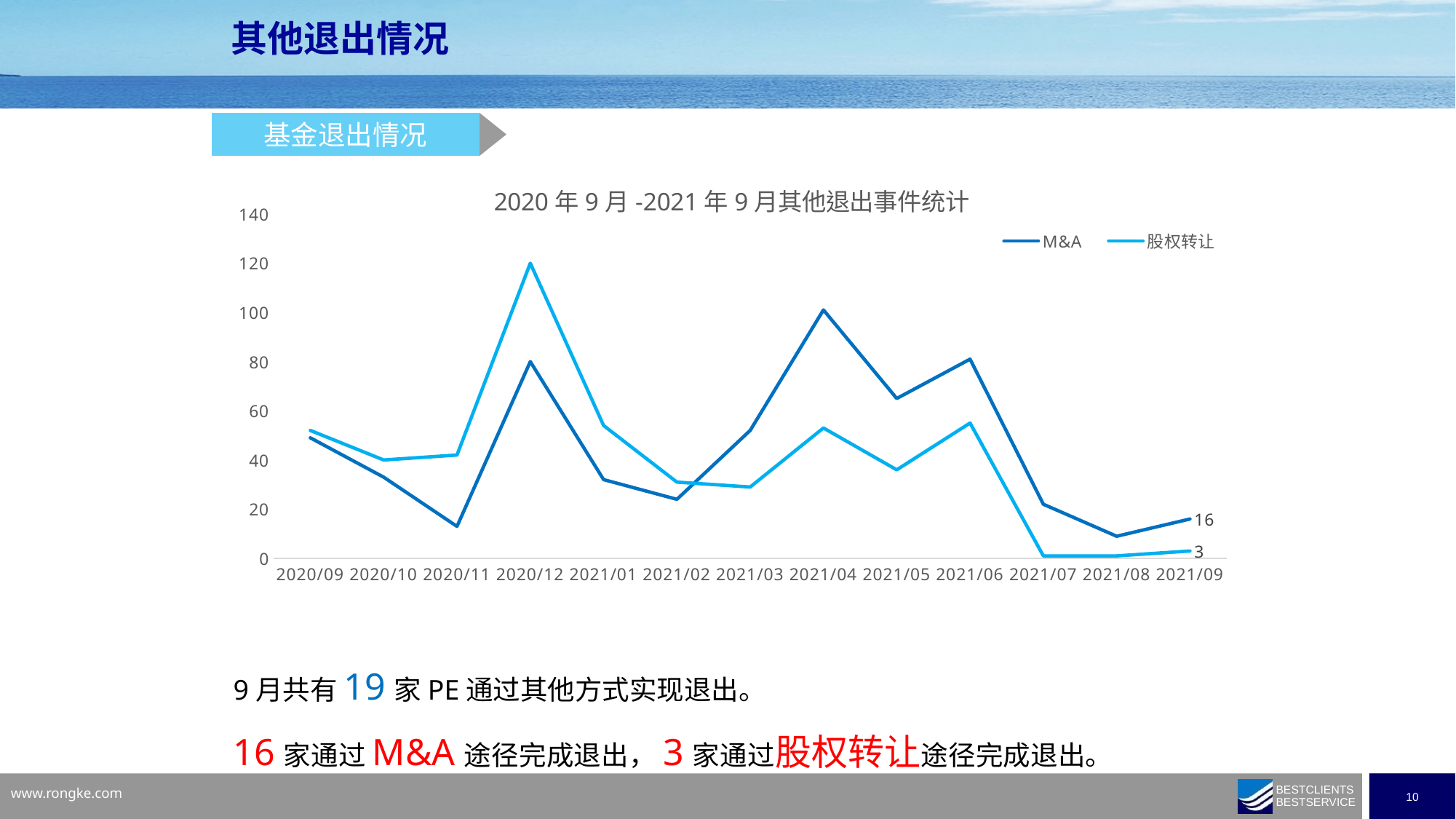
In which month does the 股权转让 series reach its highest value? 2020/12 What is the title of the chart? 2020年9月-2021年9月其他退出事件统计 How many series does the chart legend list? 2 Is the value for 股权转让 at 2020/12 greater or less than 100? greater In which month does the M&A series reach its highest value? 2021/04 Is the value for M&A at 2020/11 greater or less than 20? less What kind of chart is shown on the slide? Line chart At 2021/09, which series has the larger value, M&A or 股权转让? M&A How many months are shown on the x axis of the chart? 13 What is the value of the M&A series at 2021/09? 16 What is the value of the 股权转让 series at 2021/09? 3 What is the difference between the M&A value and the 股权转让 value at 2021/09? 13